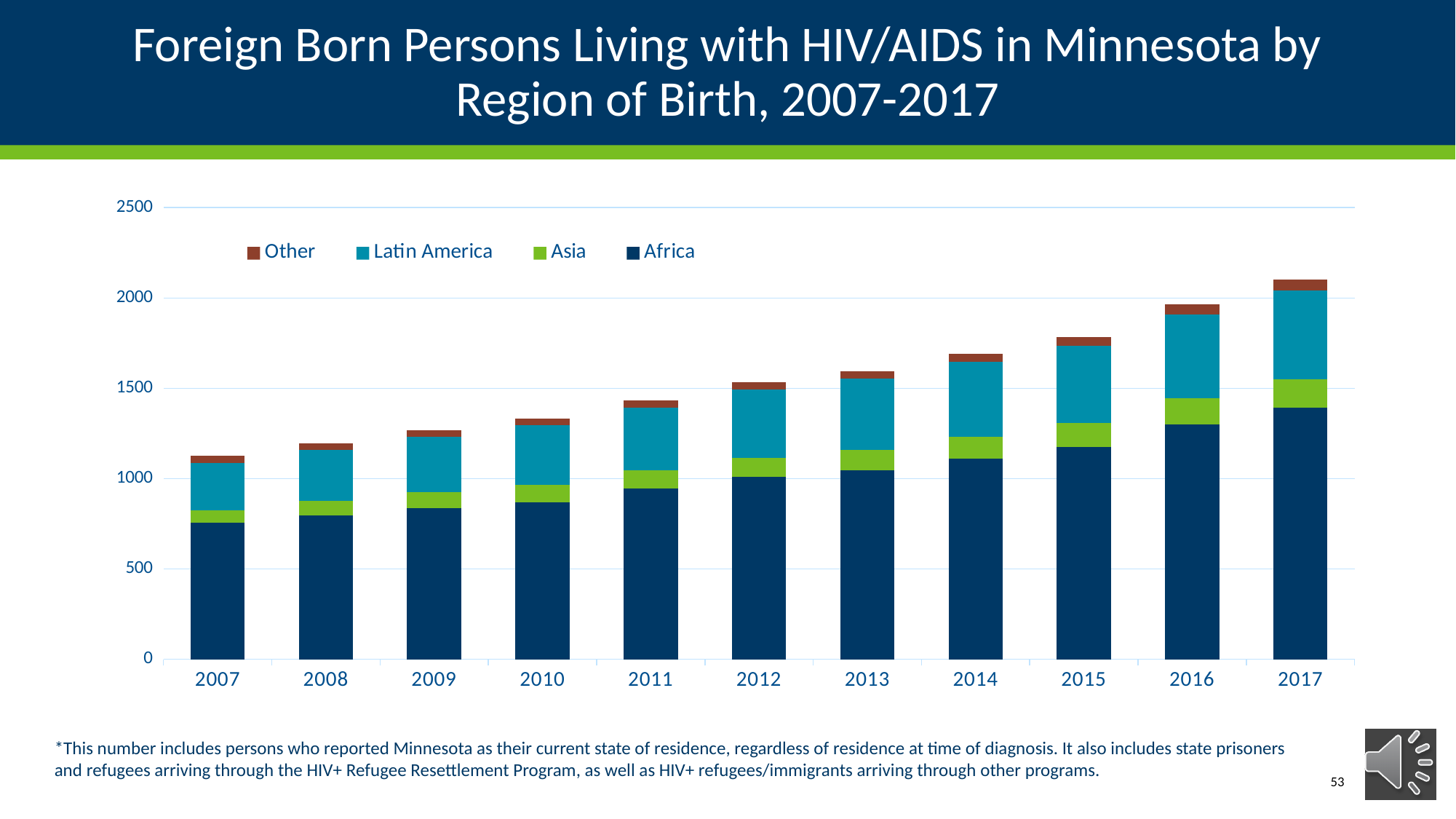
Which year has the highest total bar? 2017 What kind of chart is shown on the slide? Stacked bar chart How many years are shown on the x axis? 11 Is the Africa segment for 2007 greater or less than 500? greater Which region is shown by the dark blue segment at the bottom of each bar? Africa Is the total bar for 2017 greater or less than 2000? greater Is the Africa segment for 2017 greater or less than 1000? greater Which is larger, the total bar for 2017 or the total bar for 2007? 2017 Do the total bar heights rise or fall from 2007 to 2017? Rise How many series does the legend list? 4 Which year has the lowest total bar? 2007